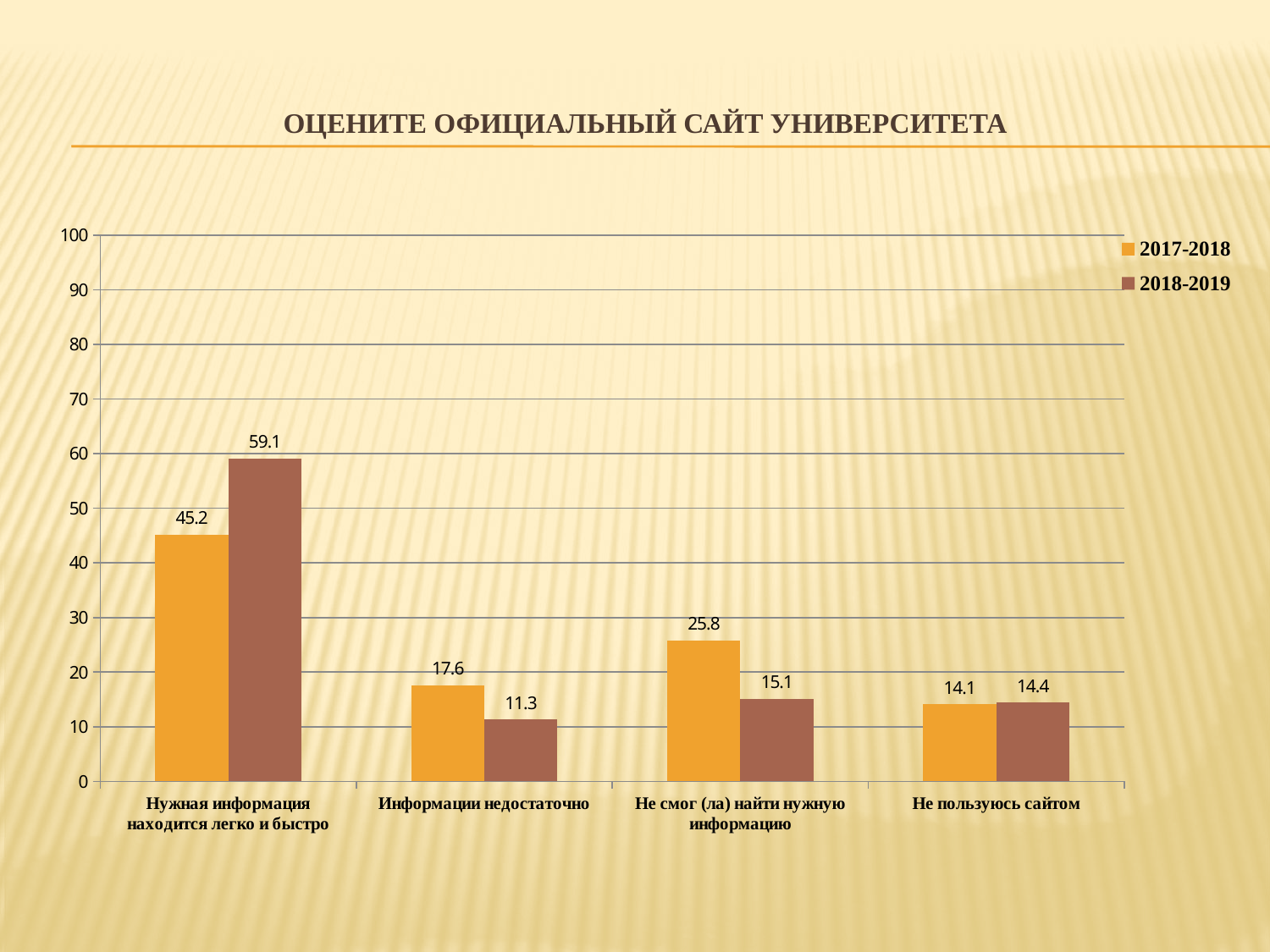
What is the value for "Не смог (ла) найти нужную информацию" in the 2018-2019 series? 15.1 What is the value for "Нужная информация находится легко и быстро" in the 2018-2019 series? 59.1 Which category has the highest value in the 2017-2018 series? Нужная информация находится легко и быстро What kind of chart is shown on the slide? bar chart How many series does the legend list? 2 Which series has the larger value for "Не смог (ла) найти нужную информацию", 2017-2018 or 2018-2019? 2017-2018 How many categories are shown on the x axis? 4 Which category has the lowest value in the 2018-2019 series? Информации недостаточно What is the value for "Информации недостаточно" in the 2017-2018 series? 17.6 What is the title of the chart? ОЦЕНИТЕ ОФИЦИАЛЬНЫЙ САЙТ УНИВЕРСИТЕТА What is the difference between the 2018-2019 and 2017-2018 values for "Нужная информация находится легко и быстро"? 13.9 Is the 2017-2018 value for "Не смог (ла) найти нужную информацию" greater or less than 20? greater